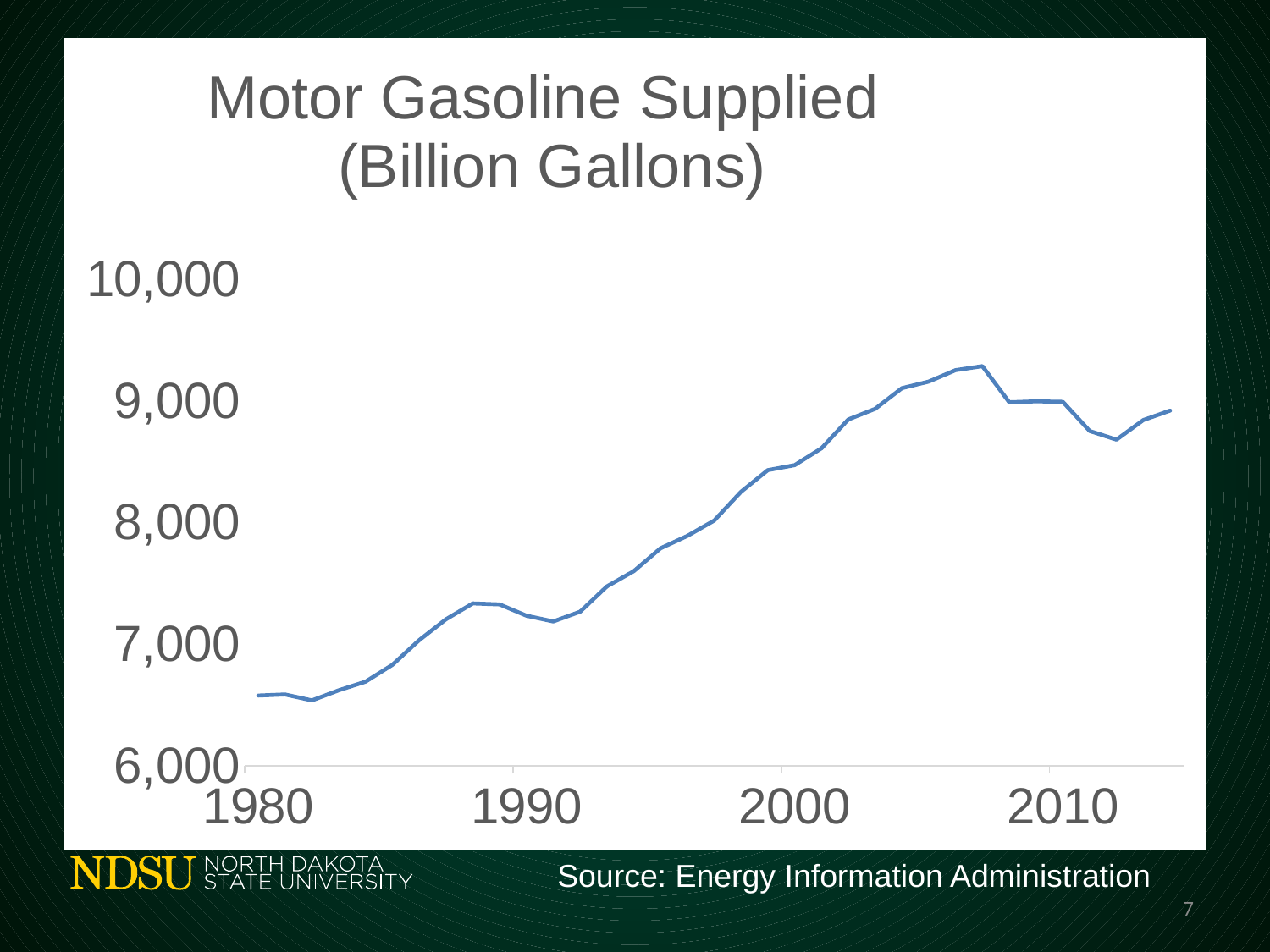
Is the value for 2000 greater or less than 9,000? less Which year has the larger value, 1980 or 2010? 2010 What kind of chart is shown on the slide? line chart What is the highest value shown on the y axis? 10,000 What is the title of the chart? Motor Gasoline Supplied (Billion Gallons) Is the value for 1990 greater or less than 7,000? greater Is the value for 2000 greater or less than 8,000? greater Do the values generally rise or fall from 1980 to 2000? rise What source is cited for the chart's data? Energy Information Administration Which year has the larger value, 1990 or 2000? 2000